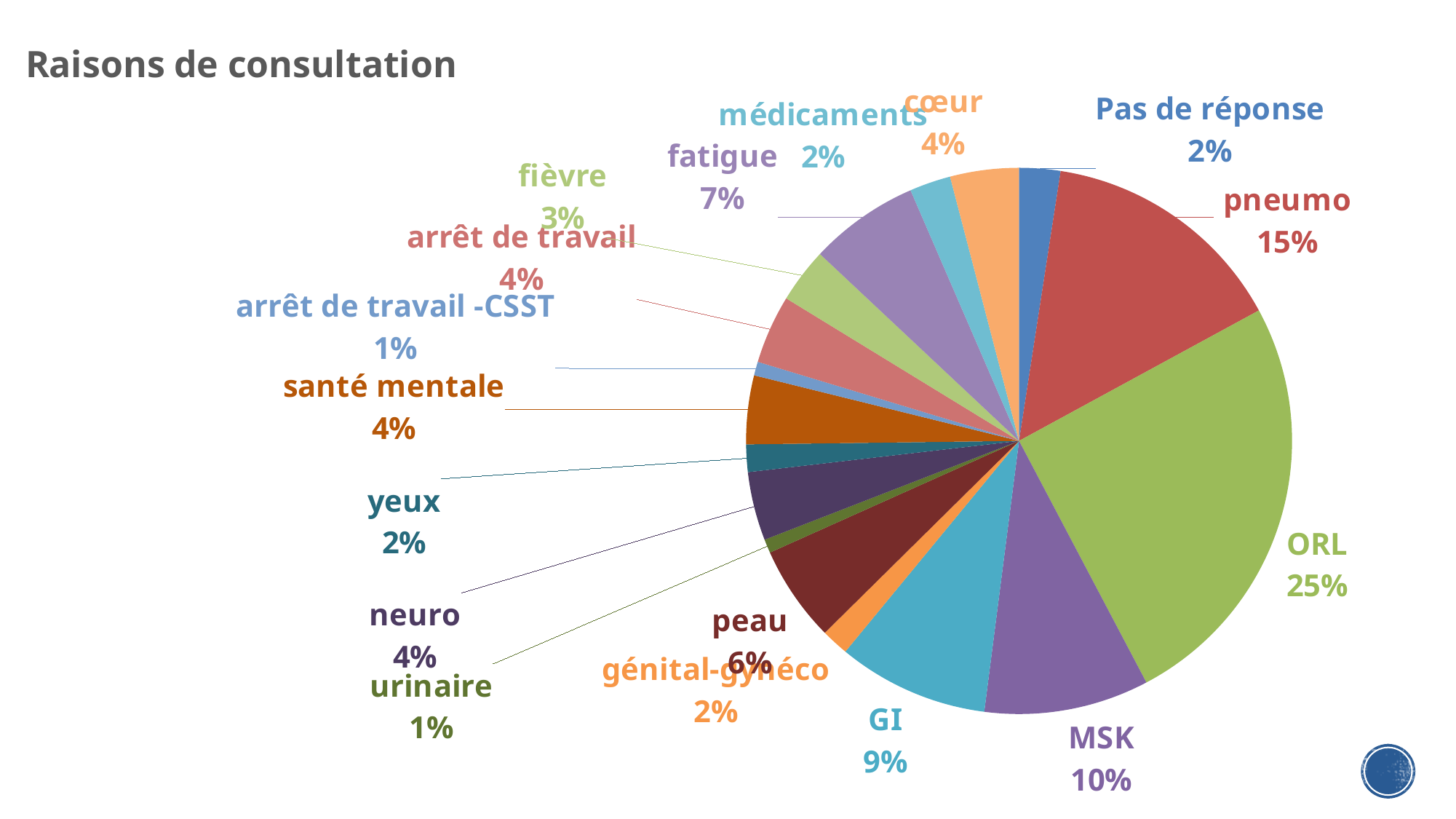
How many categories are shown in the pie chart? 17 What is the title of the chart? Raisons de consultation What is the value shown for santé mentale? 4% Which category has the largest slice of the pie? ORL Which is larger, MSK or peau? MSK What is the value shown for fatigue? 7% What is the value shown for pneumo? 15% What is the difference between the MSK and GI percentages? 1% What is the difference between the ORL and pneumo percentages? 10% What share of the pie does ORL represent? 25% What kind of chart is shown on the slide? pie chart What is the value shown for GI? 9%